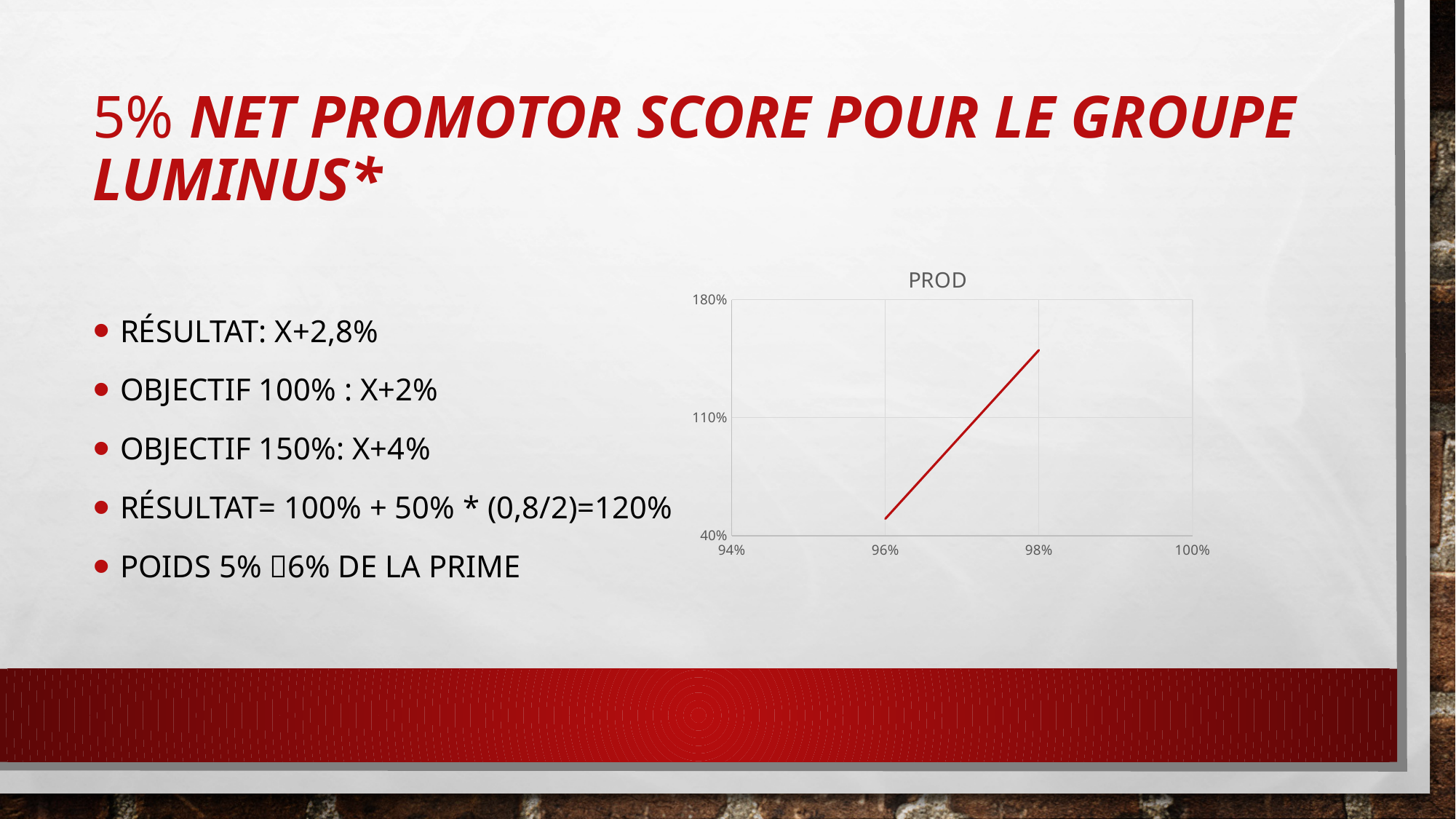
What is the highest value labelled on the y axis of the PROD chart? 180% In the PROD chart, is the value at 98% greater or less than 110%? greater In the PROD chart, is the value higher at 96% or at 98%? 98% In the PROD chart, is the value at 98% greater or less than 180%? less In the PROD chart, is the value at 96% greater or less than 40%? greater What is the title of the chart? PROD Does the line in the PROD chart rise or fall as the x-axis value increases from 96% to 98%? rise What kind of chart is shown on the slide? line chart